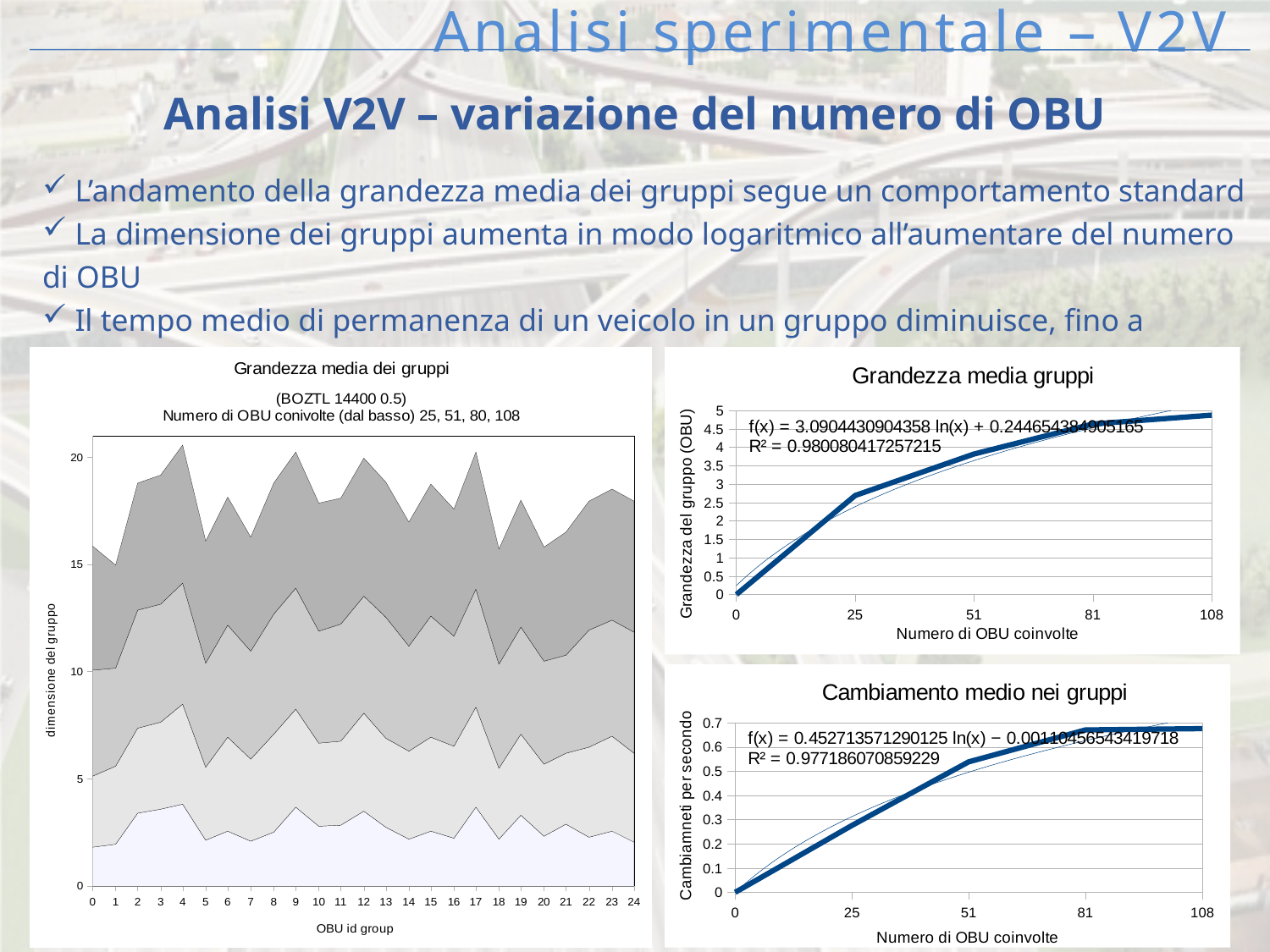
In the chart titled 'Grandezza media gruppi' (top right), is the value at 51 OBU greater or less than 3.5? greater In the chart titled 'Grandezza media gruppi' (top right), what is the R² value printed on the chart? 0.980080417257215 What is the y-axis title of the chart titled 'Grandezza media gruppi' (top right)? Grandezza del gruppo (OBU) In the chart titled 'Cambiamento medio nei gruppi' (bottom right), do the values rise or fall along the x axis? rise In the chart titled 'Cambiamento medio nei gruppi' (bottom right), is the value at 51 OBU greater or less than 0.5? greater In the chart titled 'Grandezza media gruppi' (top right), which x-axis value has the highest plotted value? 108 In the chart titled 'Cambiamento medio nei gruppi' (bottom right), what is the R² value printed on the chart? 0.977186070859229 What kind of chart is the left chart titled 'Grandezza media dei gruppi'? stacked area chart In the left chart 'Grandezza media dei gruppi', how many OBU id groups are shown on the x axis? 25 In the chart titled 'Grandezza media gruppi' (top right), do the values rise or fall as the number of OBU increases along the x axis? rise In the chart titled 'Grandezza media gruppi' (top right), is the value at 108 OBU greater or less than 5? less